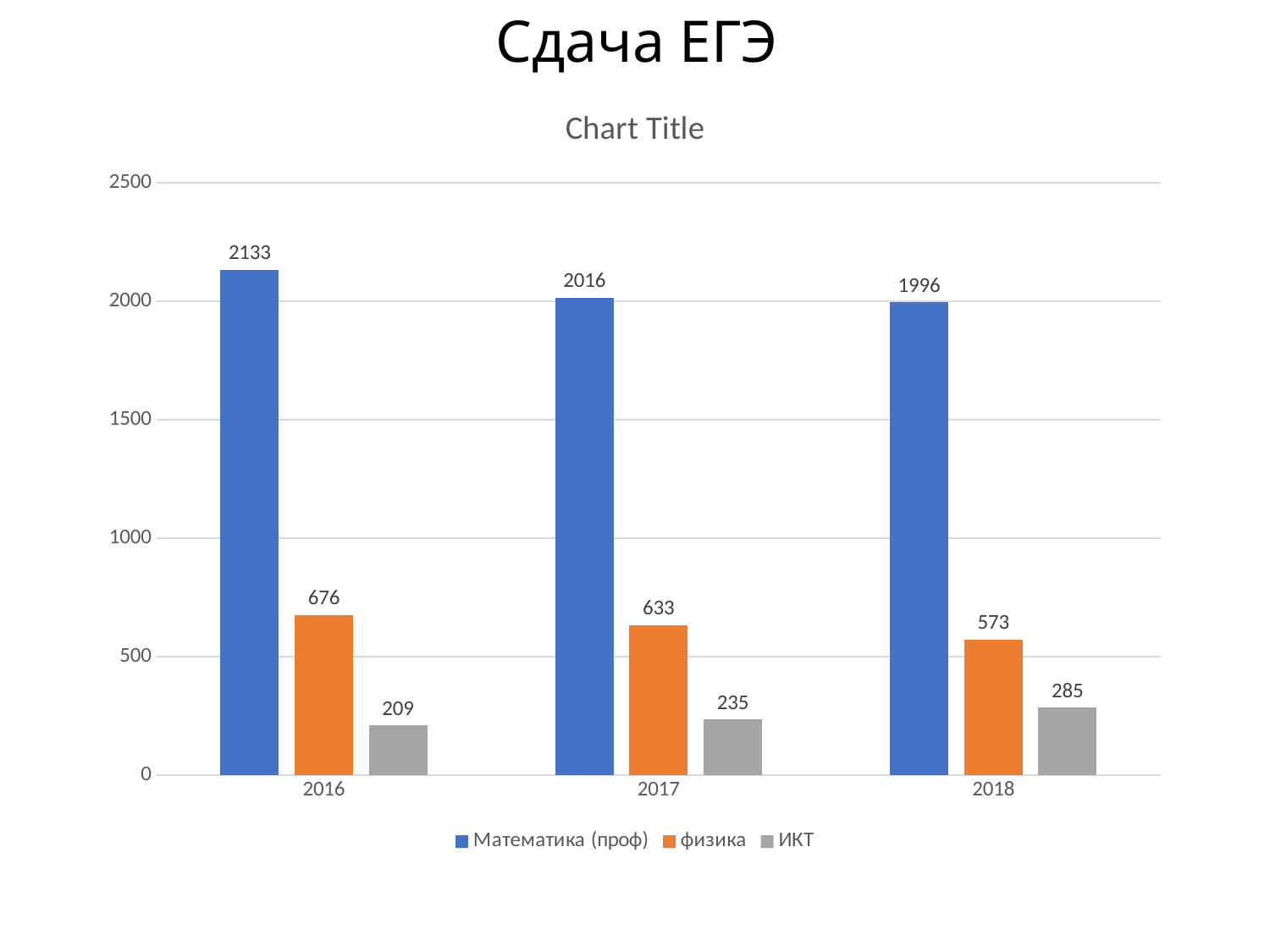
How many series does the legend list? 3 What is the value for ИКТ in 2017? 235 How many years are shown on the x axis? 3 In which year is the value for Математика (проф) highest? 2016 What is the value for Математика (проф) in 2016? 2133 What is the difference between the физика values for 2016 and 2018? 103 What kind of chart is shown on the slide? bar chart Is the value for физика in 2017 greater or less than 500? greater What is the value for физика in 2018? 573 Which is larger: ИКТ in 2018 or ИКТ in 2017? ИКТ in 2018 Do the values for Математика (проф) rise or fall from 2016 to 2018? fall In which year is the value for ИКТ lowest? 2016